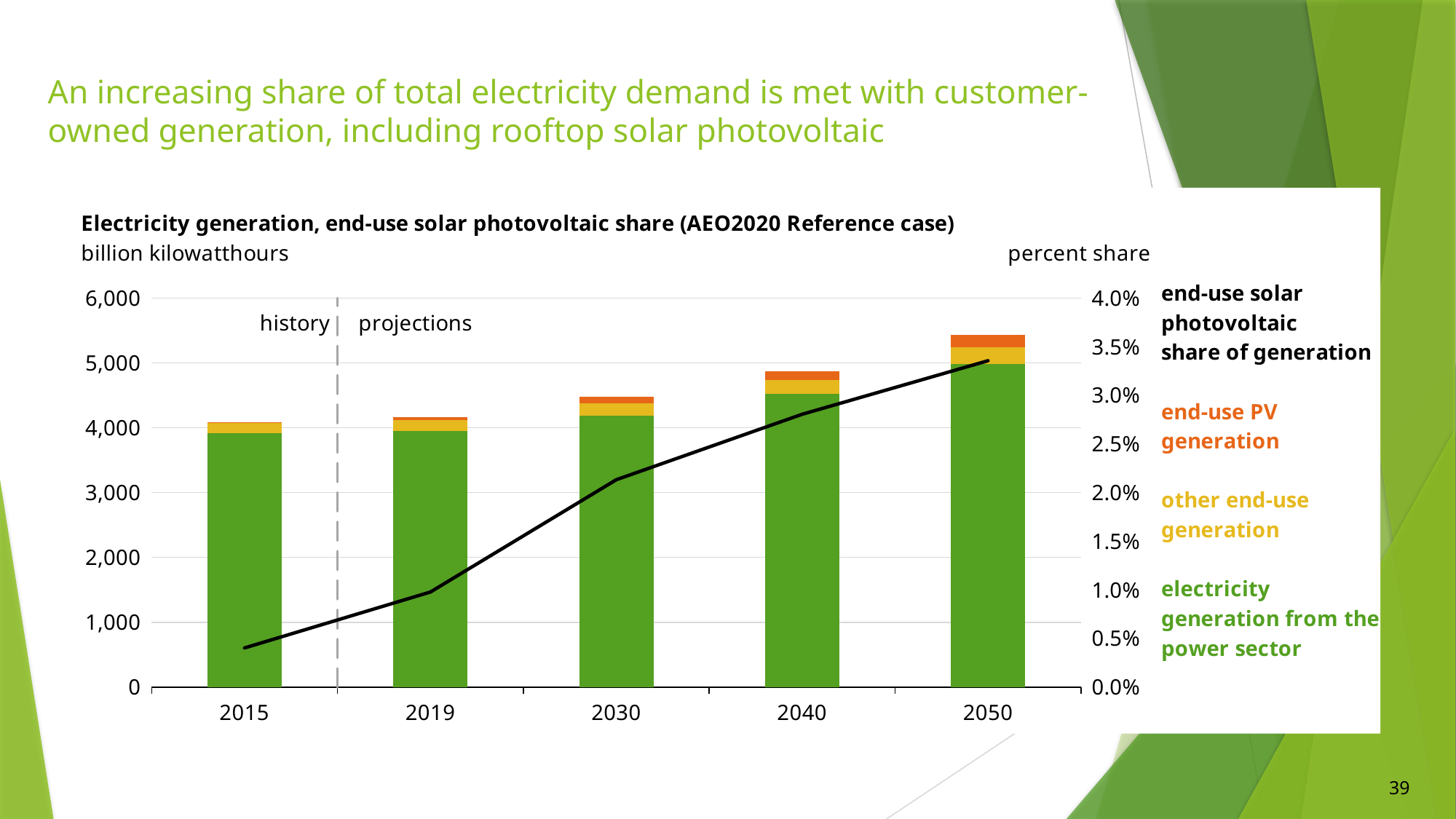
What kind of chart is shown on the slide? A stacked bar chart combined with a line How many series does the chart's legend list? 4 Does the end-use solar photovoltaic share of generation line rise or fall from 2015 to 2050? rise Which year has the highest total electricity generation bar? 2050 Is the total electricity generation bar for 2050 greater or less than 5,000 billion kilowatthours? greater Is the end-use solar photovoltaic share of generation in 2050 greater or less than 3.0%? greater How many years are shown on the x axis of the chart? 5 Is the end-use solar photovoltaic share of generation in 2019 greater or less than 1.5%? less Which is larger, the total electricity generation bar for 2015 or for 2050? 2050 Which colour represents electricity generation from the power sector in the chart? Green